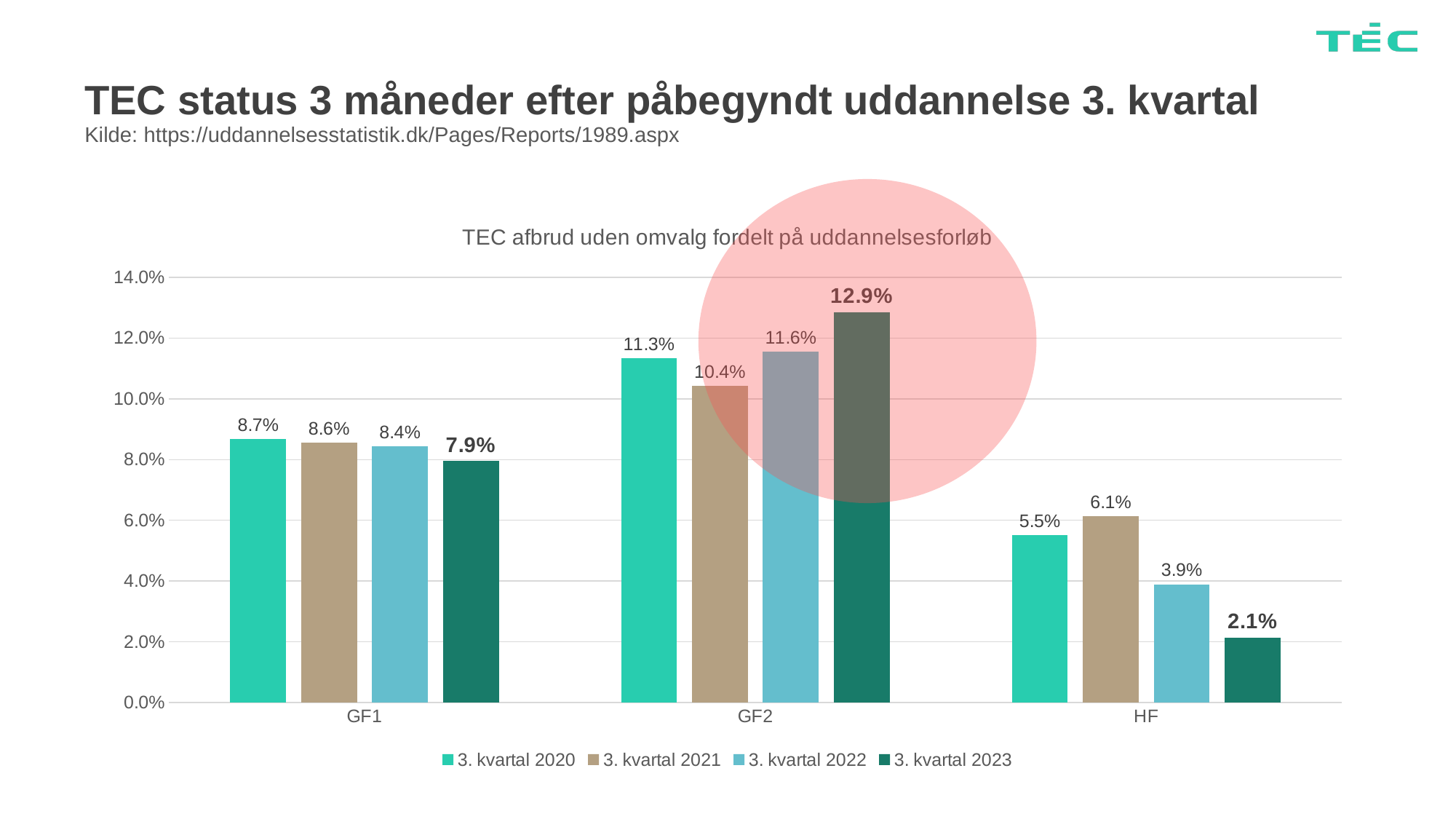
What is the title of the chart? TEC afbrud uden omvalg fordelt på uddannelsesforløb What is the value for GF2 in 3. kvartal 2023? 12.9% Which category has the lowest value in 3. kvartal 2023? HF What is the difference between the GF2 and GF1 values in 3. kvartal 2023? 5.0% How many series does the legend list? 4 Is the value for GF2 in 3. kvartal 2022 greater or less than 10.0%? greater What is the value for HF in 3. kvartal 2022? 3.9% How many categories are shown on the x axis? 3 What is the value for GF1 in 3. kvartal 2020? 8.7% Which category has the highest value in 3. kvartal 2021? GF2 Which is larger for HF: the 3. kvartal 2020 value or the 3. kvartal 2021 value? 3. kvartal 2021 What kind of chart is shown on the slide? Bar chart